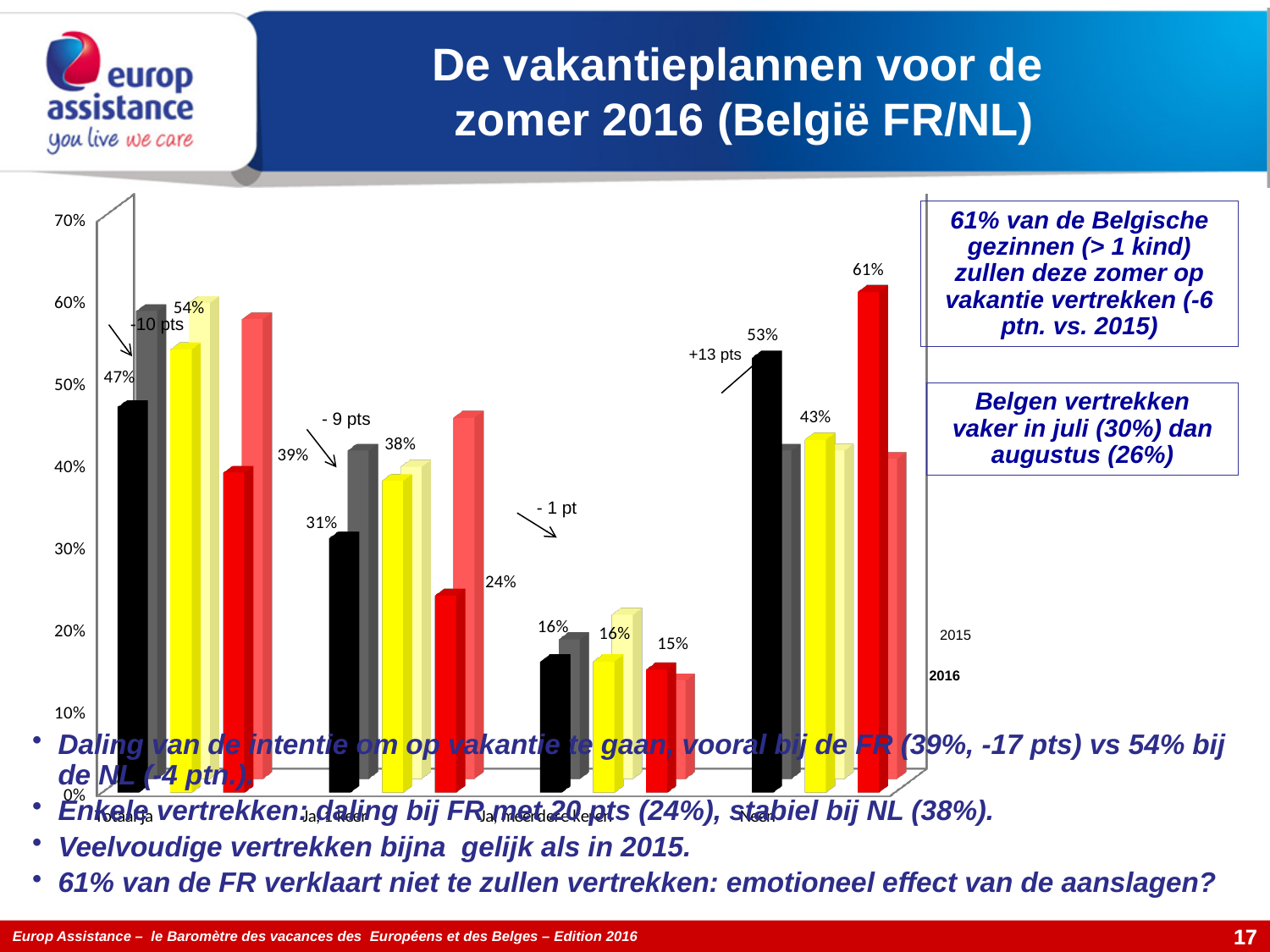
What kind of chart is shown on the slide? bar chart What is the value labelled on the red bar for the category 'Neen'? 61% What change in points is annotated above the 'Neen' category? +13 pts What is the value labelled on the black bar for the category 'Totaal ja'? 47% What is the value labelled on the black bar for the category 'Ja, 1 keer'? 31% What is the value labelled on the black bar for the category 'Neen'? 53% What is the difference between the black bar for 'Neen' (53%) and the black bar for 'Totaal ja' (47%)? 6 percentage points What change in points is annotated for the 'Ja, meerdere keren' category? - 1 pt Which is larger: the black bar for 'Totaal ja' or the black bar for 'Neen'? Neen Which years does the chart legend list? 2015 and 2016 Is the value of the black bar for 'Ja, meerdere keren' greater or less than 20%? less How many categories are shown along the x axis of the chart? 4